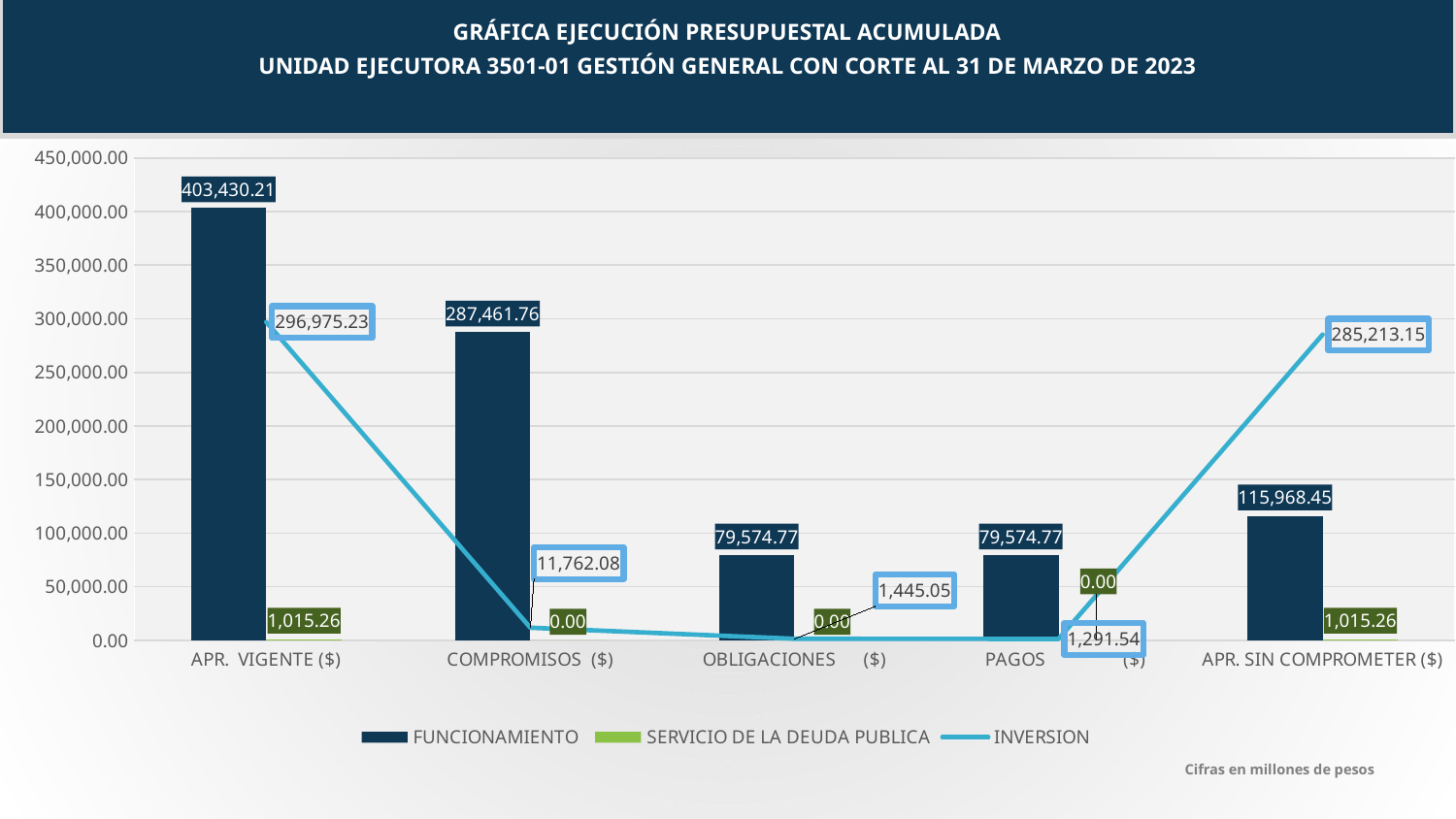
How many categories are shown on the x axis? 5 What is the difference between the FUNCIONAMIENTO values for APR. VIGENTE ($) and COMPROMISOS ($)? 115,968.45 What is the INVERSION value for COMPROMISOS ($)? 11,762.08 What is the INVERSION value for APR. SIN COMPROMETER ($)? 285,213.15 Which is larger: the INVERSION value for APR. VIGENTE ($) or for APR. SIN COMPROMETER ($)? APR. VIGENTE ($) What is the SERVICIO DE LA DEUDA PUBLICA value for APR. VIGENTE ($)? 1,015.26 Which category has the highest FUNCIONAMIENTO value? APR. VIGENTE ($) What unit note is printed below the chart? Cifras en millones de pesos What is the FUNCIONAMIENTO value for APR. VIGENTE ($)? 403,430.21 Which category has the lowest INVERSION value? PAGOS ($) Which series is drawn as a line rather than bars? INVERSION How many series does the legend list? 3